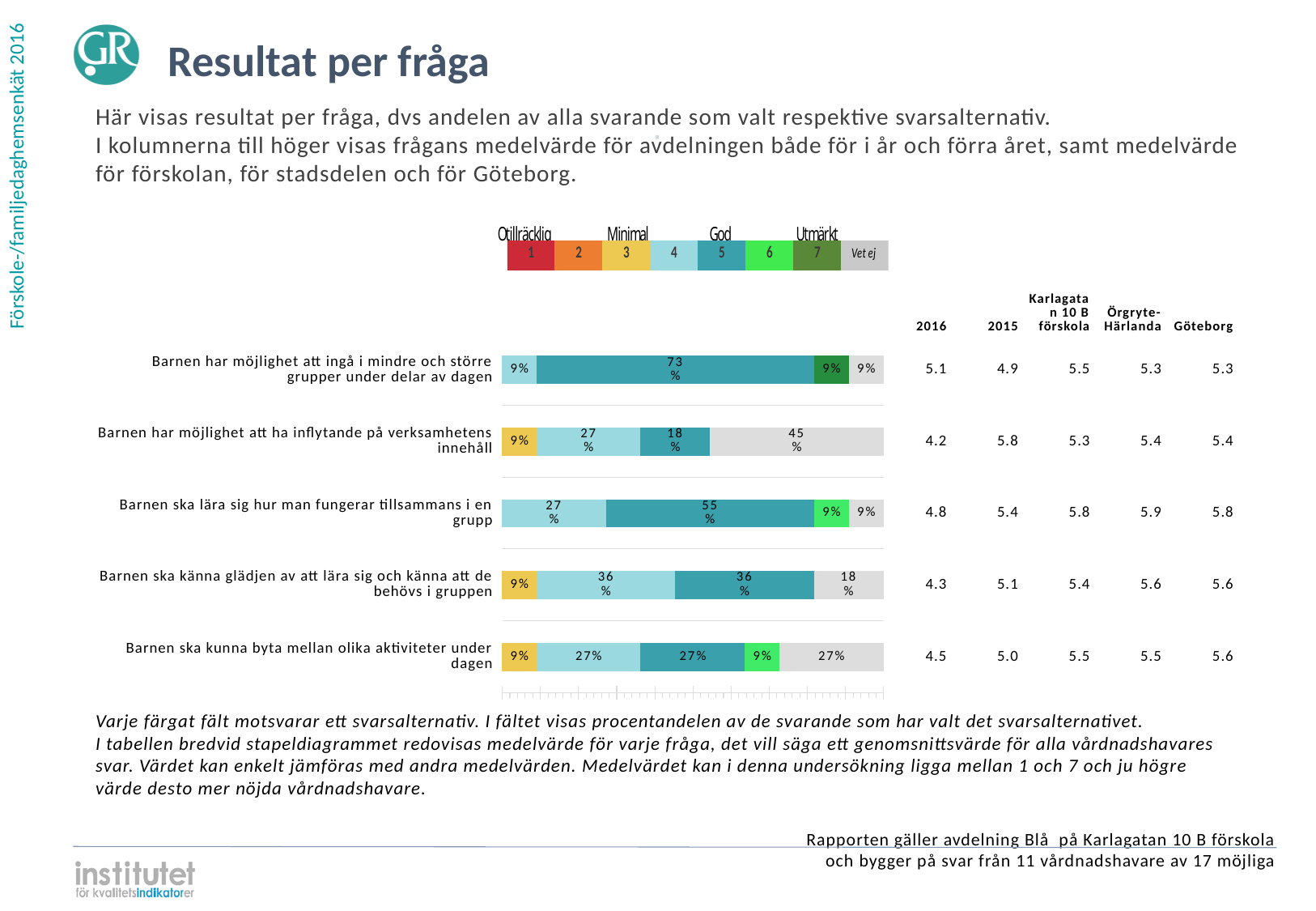
For 'Barnen ska kunna byta mellan olika aktiviteter under dagen', which is larger: the share for answer 4 (light blue) or the share for answer 6 (green)? Answer 4 (27%) How many questions (bars) are shown in the chart? 5 How many answer alternatives does the legend above the chart list, including 'Vet ej'? 8 What percentage of respondents chose answer 5 (God) for 'Barnen ska lära sig hur man fungerar tillsammans i en grupp'? 55% What is the Göteborg mean value for 'Barnen ska lära sig hur man fungerar tillsammans i en grupp'? 5.8 Which question has the largest 'Vet ej' (grey) share? Barnen har möjlighet att ha inflytande på verksamhetens innehåll What percentage of respondents chose answer 5 (God) for 'Barnen har möjlighet att ingå i mindre och större grupper under delar av dagen'? 73% What kind of chart is shown on the slide? Stacked bar chart What is the difference between the 'Vet ej' share for 'Barnen har möjlighet att ha inflytande på verksamhetens innehåll' (45%) and for 'Barnen ska känna glädjen av att lära sig och känna att de behövs i gruppen' (18%)? 27% What is the 2016 mean value for 'Barnen har möjlighet att ha inflytande på verksamhetens innehåll'? 4.2 Which question has the highest 2016 mean value in the table? Barnen har möjlighet att ingå i mindre och större grupper under delar av dagen What percentage of respondents answered 'Vet ej' for 'Barnen har möjlighet att ha inflytande på verksamhetens innehåll'? 45%